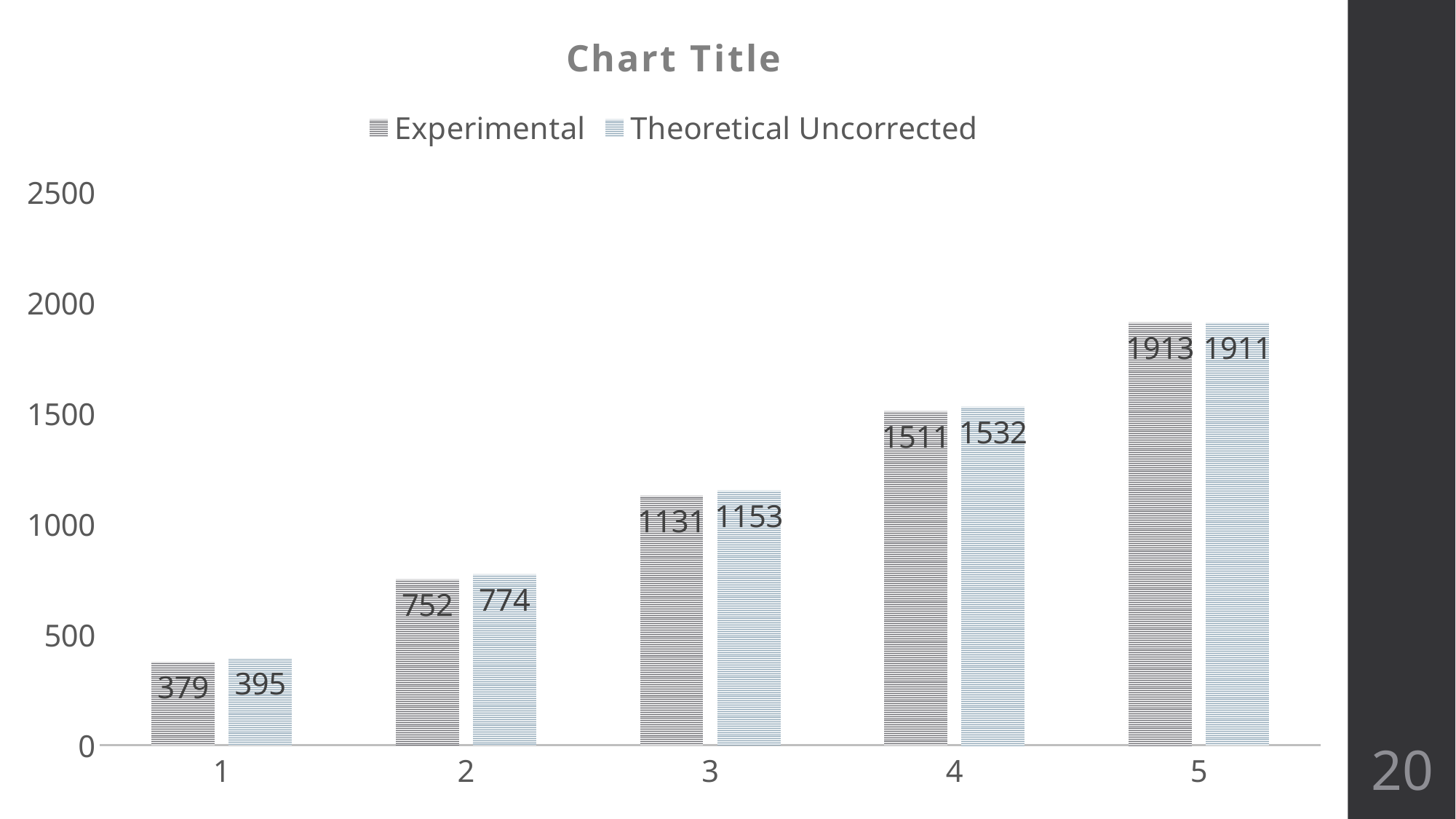
Which category has the lowest Experimental value? 1 What kind of chart is shown on the slide? Bar chart Which category has the highest Theoretical Uncorrected value? 5 Do the Experimental values rise or fall from category 1 to category 5? Rise What is the Experimental value for category 3? 1131 What is the difference between the Theoretical Uncorrected and Experimental values for category 4? 21 Which is larger for category 1, the Experimental value or the Theoretical Uncorrected value? Theoretical Uncorrected What is the difference between the Experimental values for category 2 and category 1? 373 What is the Theoretical Uncorrected value for category 2? 774 How many series does the legend list? 2 What is the Experimental value for category 5? 1913 How many categories are shown on the x axis? 5